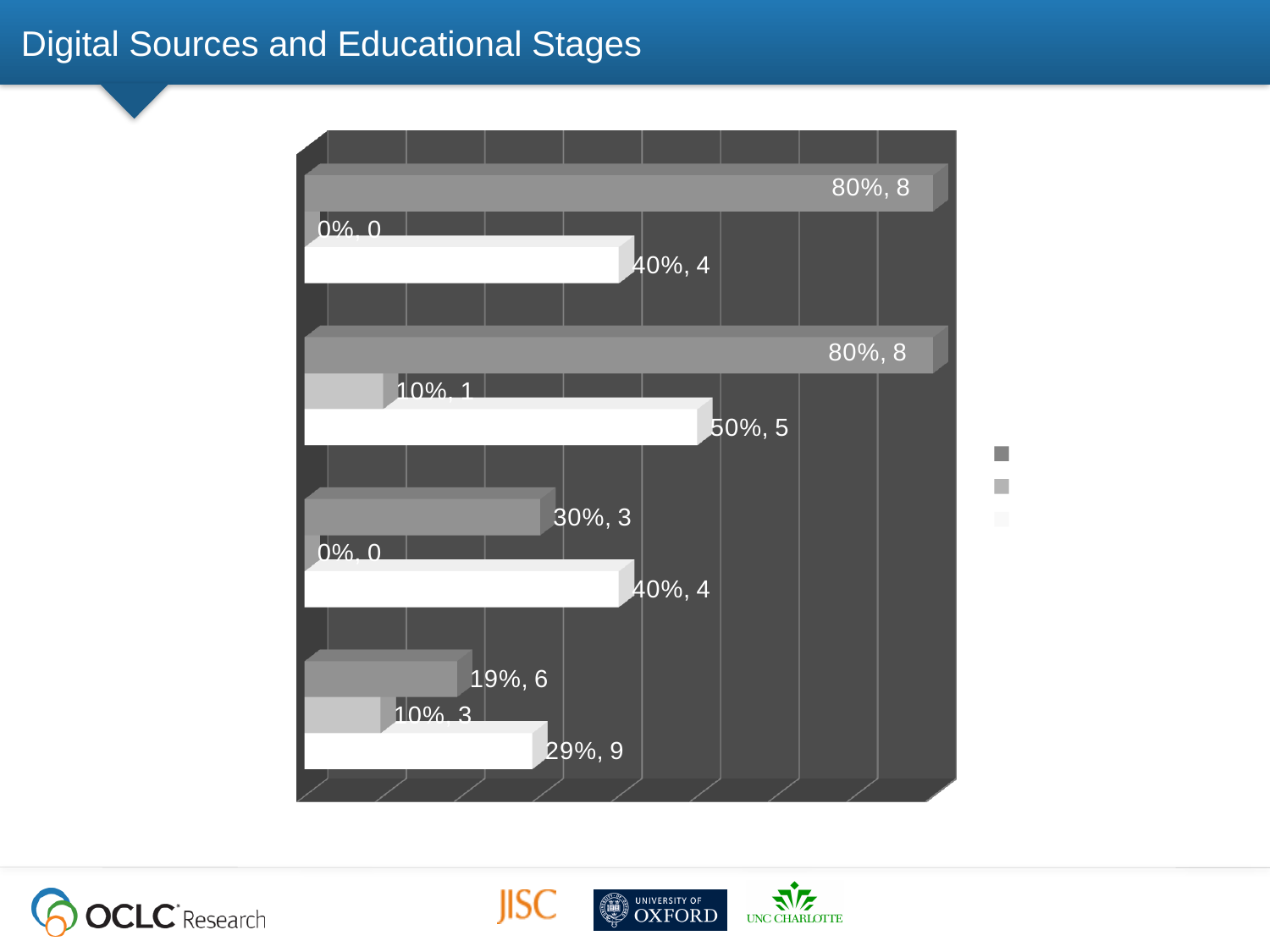
How many groups of bars does the chart contain? 4 What is the data label on the dark grey bar in the top group? 80%, 8 In the second group from the top, is the dark grey bar or the white bar larger? the dark grey bar In the bottom group, what is the difference in percentage between the white bar (29%) and the dark grey bar (19%)? 10% What kind of chart is shown on the slide? bar chart What is the data label on the dark grey bar in the third group from the top? 30%, 3 What is the data label on the white bar in the bottom group? 29%, 9 How many series does the legend list? 3 How many bars on the chart are labelled "0%, 0"? 2 In the bottom group, which bar is the longest? the white bar (29%, 9) What is the highest percentage shown on any data label in the chart? 80% What is the data label on the light grey bar in the second group from the top? 10%, 1